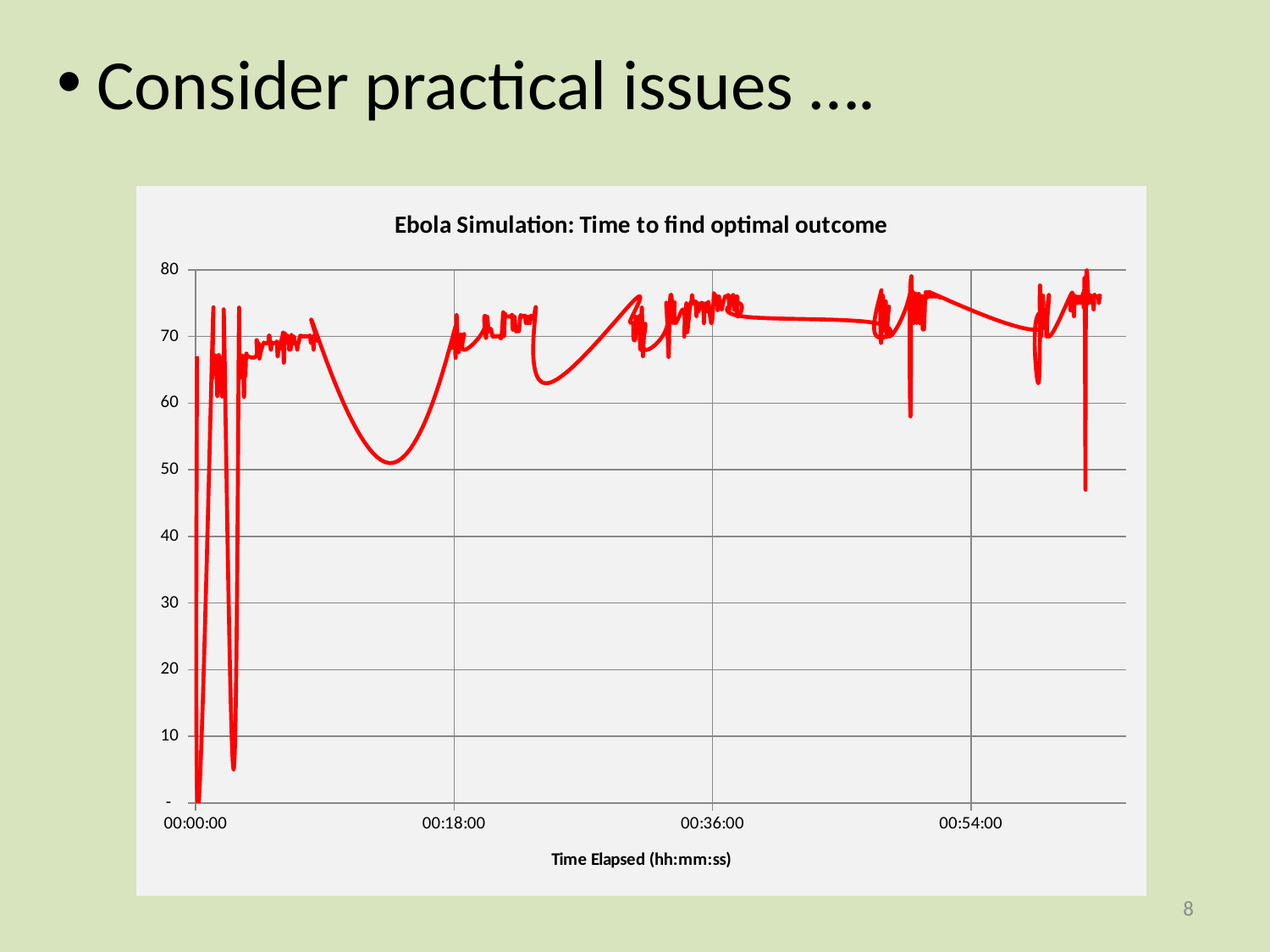
What kind of chart is shown on the slide? line chart How many data series are plotted on the chart? 1 Does the line overall rise or fall from the start of the x axis to the end? rise What is the label of the x axis? Time Elapsed (hh:mm:ss) What is the highest value shown on the y axis? 80 Is the value at 00:18:00 greater or less than 60? greater Is the lowest point of the dip between 00:00:00 and 00:18:00 greater or less than 60? less What is the title of the chart? Ebola Simulation: Time to find optimal outcome How many tick labels are shown on the x axis? 4 Is the value at 00:36:00 greater or less than 70? greater